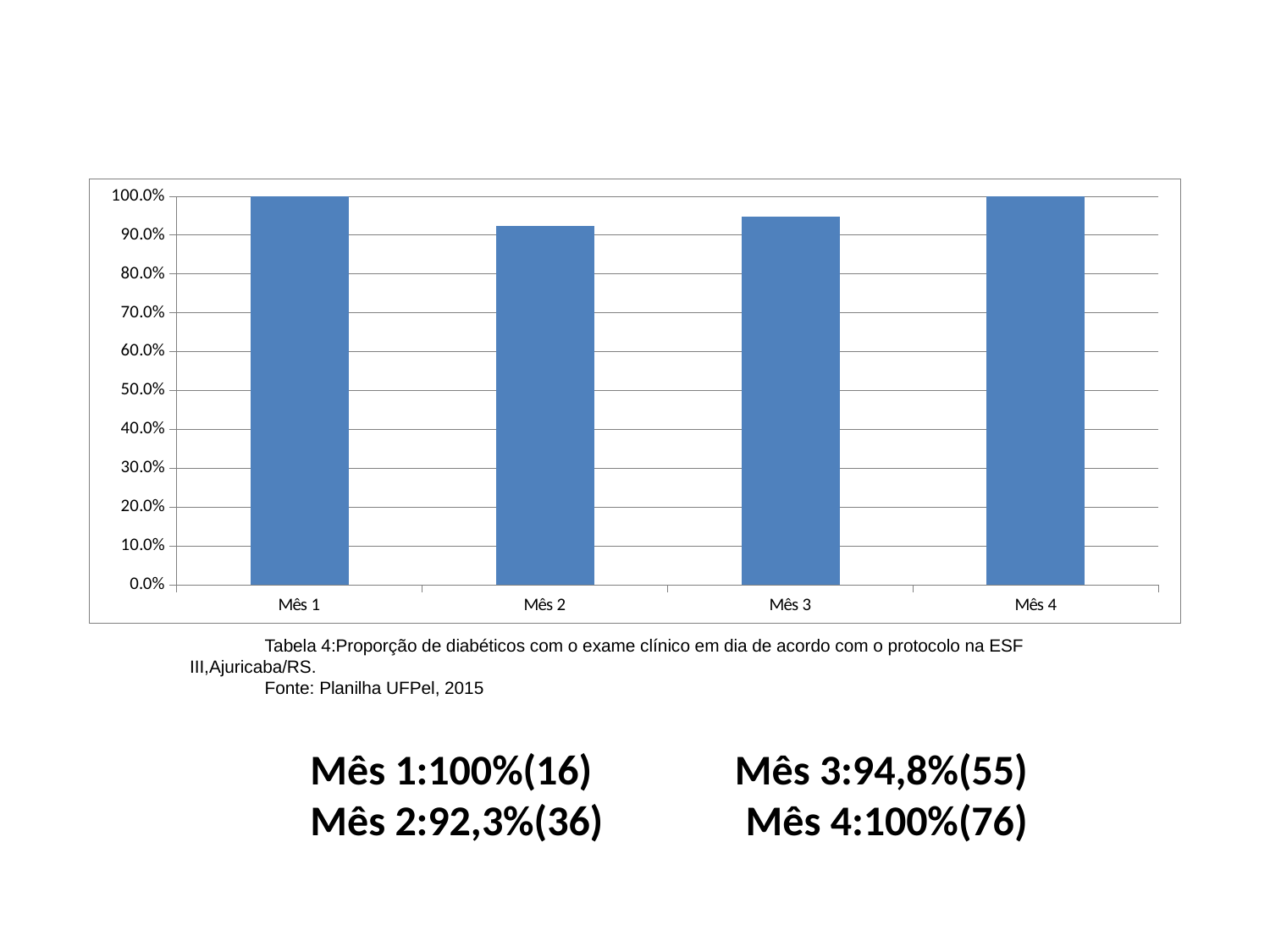
What is the value for Mês 3? 94,8% Is the value for Mês 2 greater or less than 90.0%? greater What is the value for Mês 1? 100% Which month has the lowest value? Mês 2 What is the value for Mês 2? 92,3% What is the difference between the value for Mês 1 and the value for Mês 2? 7,7% What is the difference between the value for Mês 3 and the value for Mês 2? 2,5% What is the value for Mês 4? 100% Which is larger, the value for Mês 2 or the value for Mês 3? Mês 3 What kind of chart is shown on the slide? bar chart How many bars (months) are plotted in the chart? 4 What is the source cited below the chart? Planilha UFPel, 2015